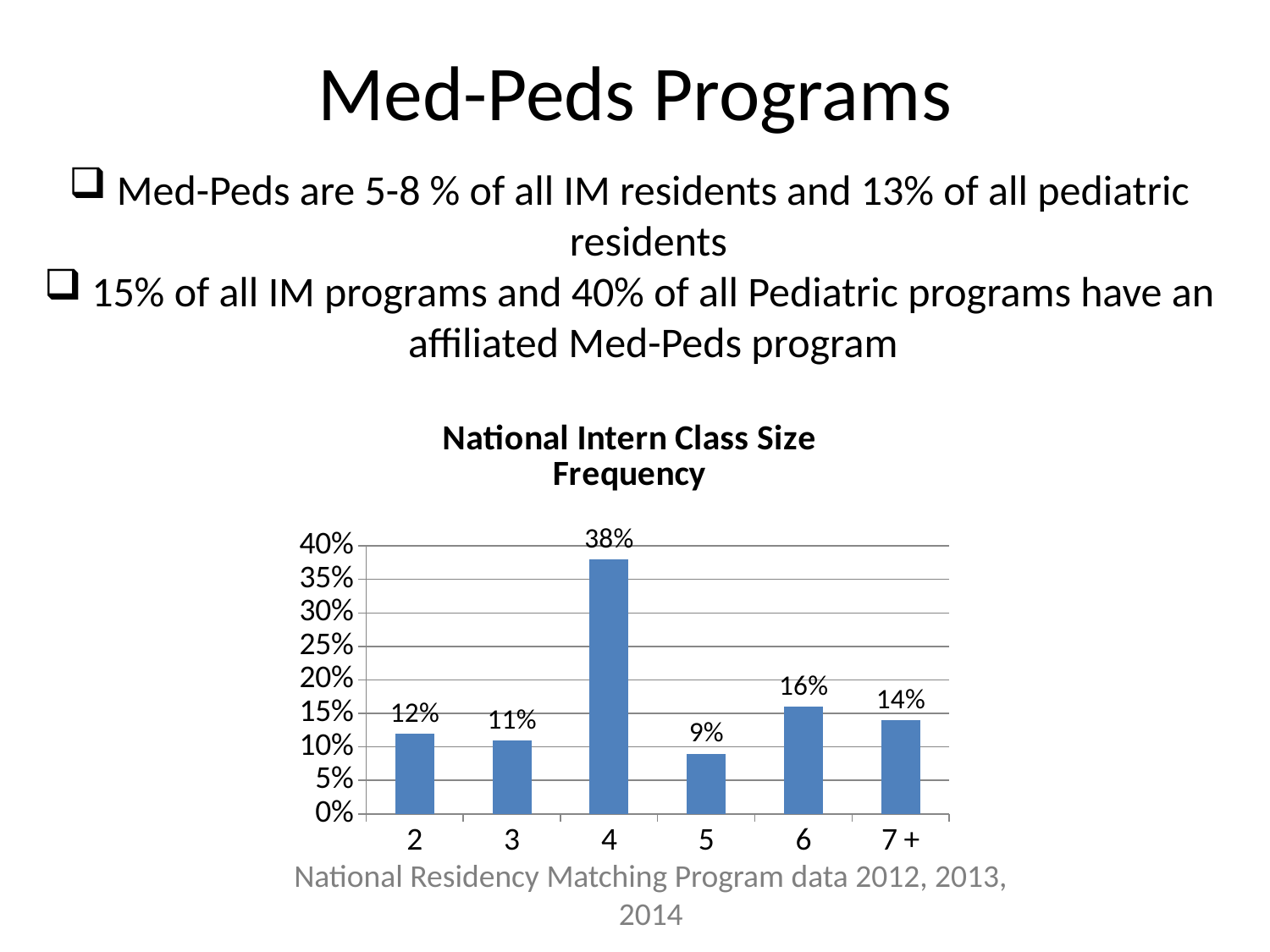
How many intern class size categories are shown on the x axis? 6 Which intern class size has the highest frequency? 4 Which intern class size has the lowest frequency? 5 What is the difference between the values for class size 4 and class size 6? 22% Which is larger, the value for class size 6 or the value for class size 7+? 6 What kind of chart is shown on the slide? bar chart What is the difference between the values for class size 2 and class size 3? 1% What is the value for intern class size 7+ in the chart? 14% What is the value for intern class size 4 in the National Intern Class Size Frequency chart? 38% What is the value for intern class size 5 in the chart? 9% What is the title of the chart? National Intern Class Size Frequency Is the value for class size 4 greater or less than 35%? greater